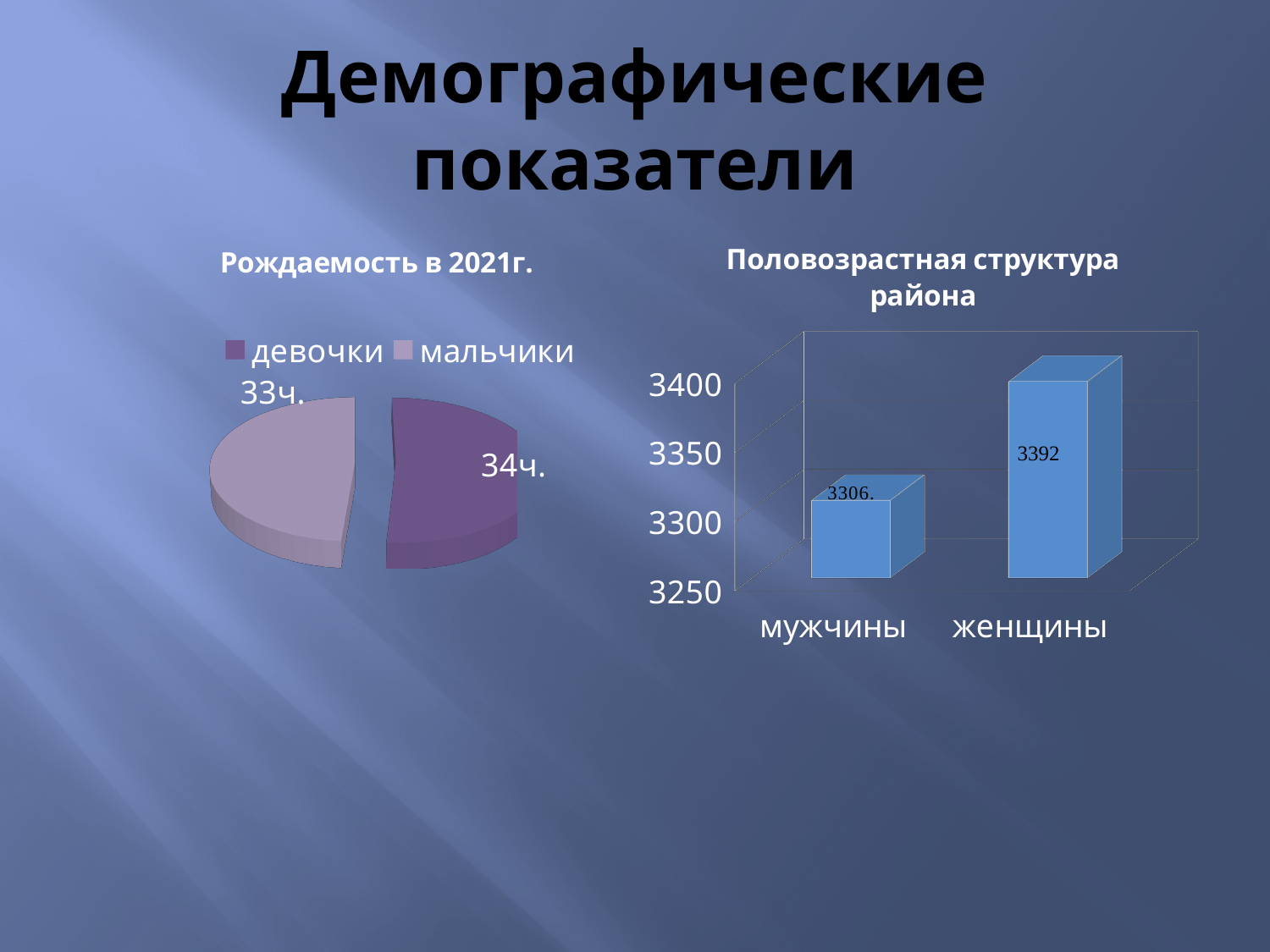
How many entries does the legend of the chart 'Рождаемость в 2021г.' list? 2 In the chart 'Рождаемость в 2021г.', what is the value for девочки? 34ч. In the chart 'Половозрастная структура района', is the value for мужчины greater or less than 3350? less In the chart 'Половозрастная структура района', what is the value for мужчины? 3306 In the chart 'Половозрастная структура района', what is the difference between the values for женщины and мужчины? 86 In the chart 'Половозрастная структура района', what is the value for женщины? 3392 What kind of chart is 'Рождаемость в 2021г.'? pie chart In the chart 'Рождаемость в 2021г.', what is the difference between the values for девочки and мальчики? 1ч. In the chart 'Рождаемость в 2021г.', which category has the larger value, девочки or мальчики? девочки In the chart 'Рождаемость в 2021г.', what is the value for мальчики? 33ч. What kind of chart is 'Половозрастная структура района'? bar chart In the chart 'Половозрастная структура района', which category has the highest value? женщины